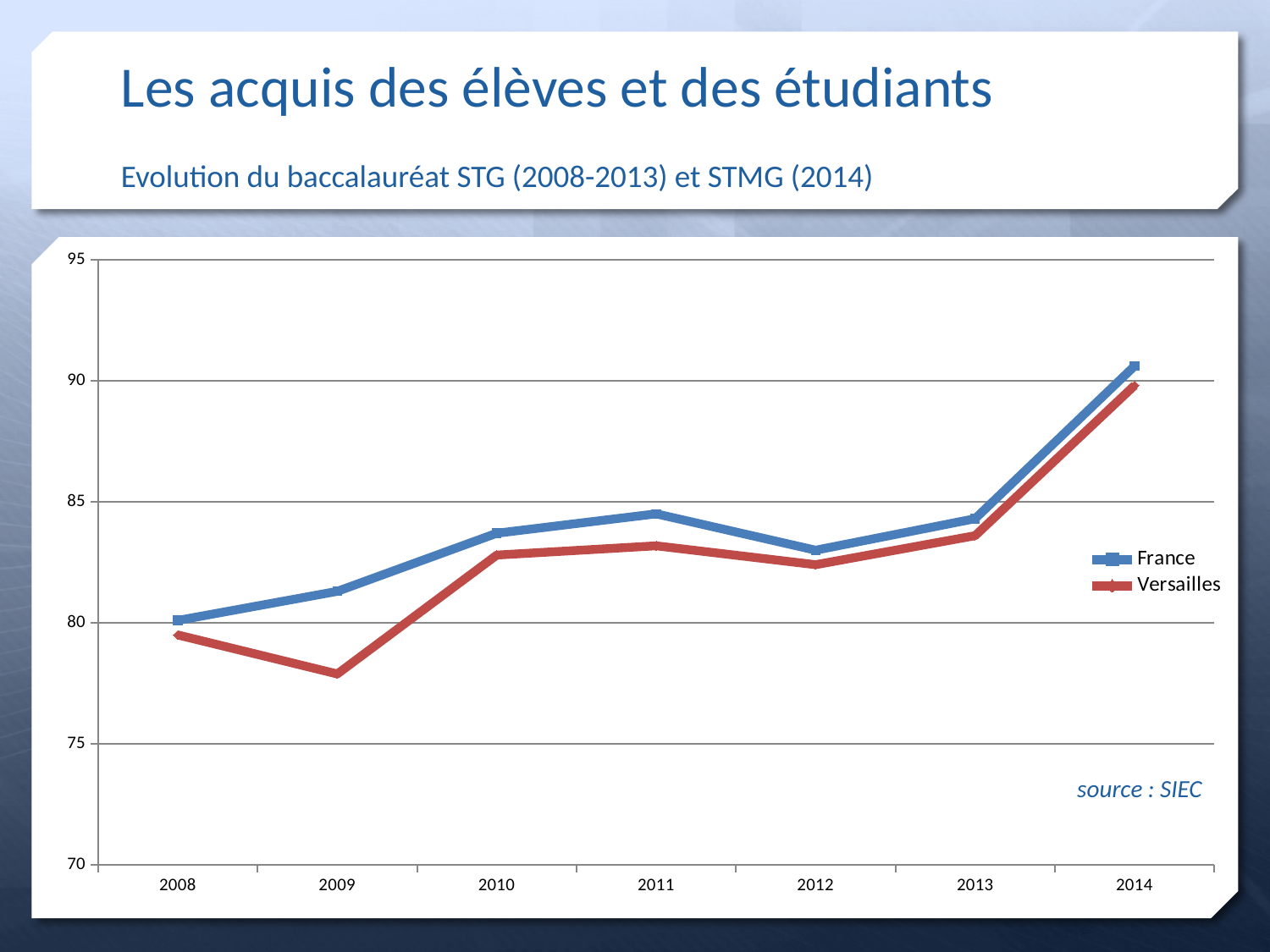
Is the value for France in 2014 greater or less than 90? greater What kind of chart is shown on the slide? line chart How many years are plotted along the x axis? 7 Is the value for Versailles in 2010 greater or less than 80? greater Is the value for Versailles in 2009 greater or less than 80? less In which year is the Versailles series at its lowest? 2009 Does the Versailles series rise or fall between 2013 and 2014? rise In 2009, which series has the higher value, France or Versailles? France Which two series are listed in the chart legend? France and Versailles How many series does the legend list? 2 In which year is the France series at its highest? 2014 What source is cited for the chart data? SIEC